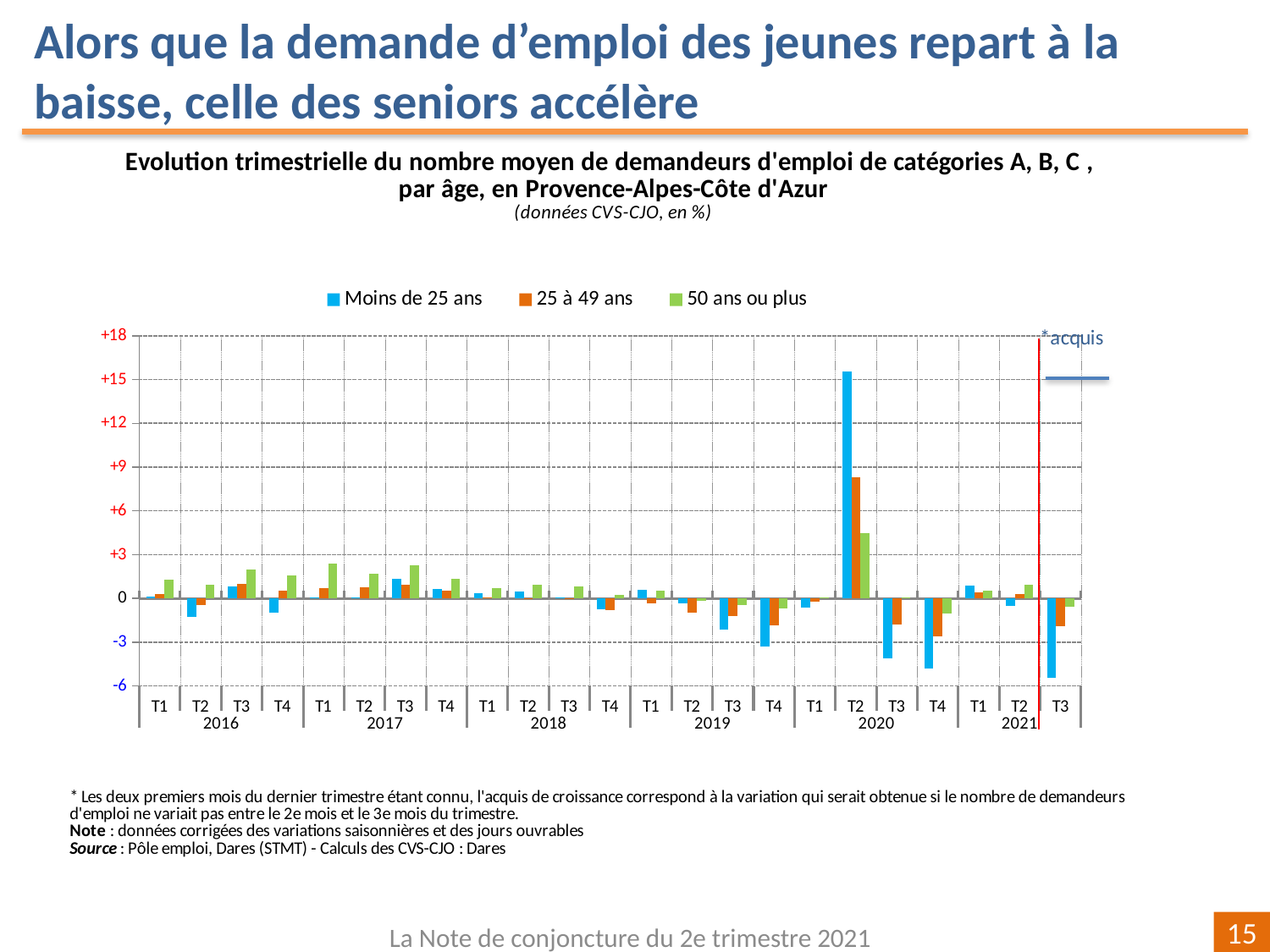
How many quarters are plotted along the x axis? 23 Which series and quarter has the lowest value on the chart? Moins de 25 ans, T3 2021 Is the value for Moins de 25 ans in T2 2020 greater or less than +12? greater Is the value for 25 à 49 ans in T2 2020 greater or less than +6? greater Which colour represents the series Moins de 25 ans in the legend? blue In T3 2021, which is larger: the value for 50 ans ou plus or for Moins de 25 ans? 50 ans ou plus Which series and quarter has the highest value on the chart? Moins de 25 ans, T2 2020 Is the value for 50 ans ou plus in T2 2020 greater or less than +3? greater How many series does the legend list? 3 In T2 2020, which is larger: the value for Moins de 25 ans or for 25 à 49 ans? Moins de 25 ans What kind of chart is shown on the slide? bar chart